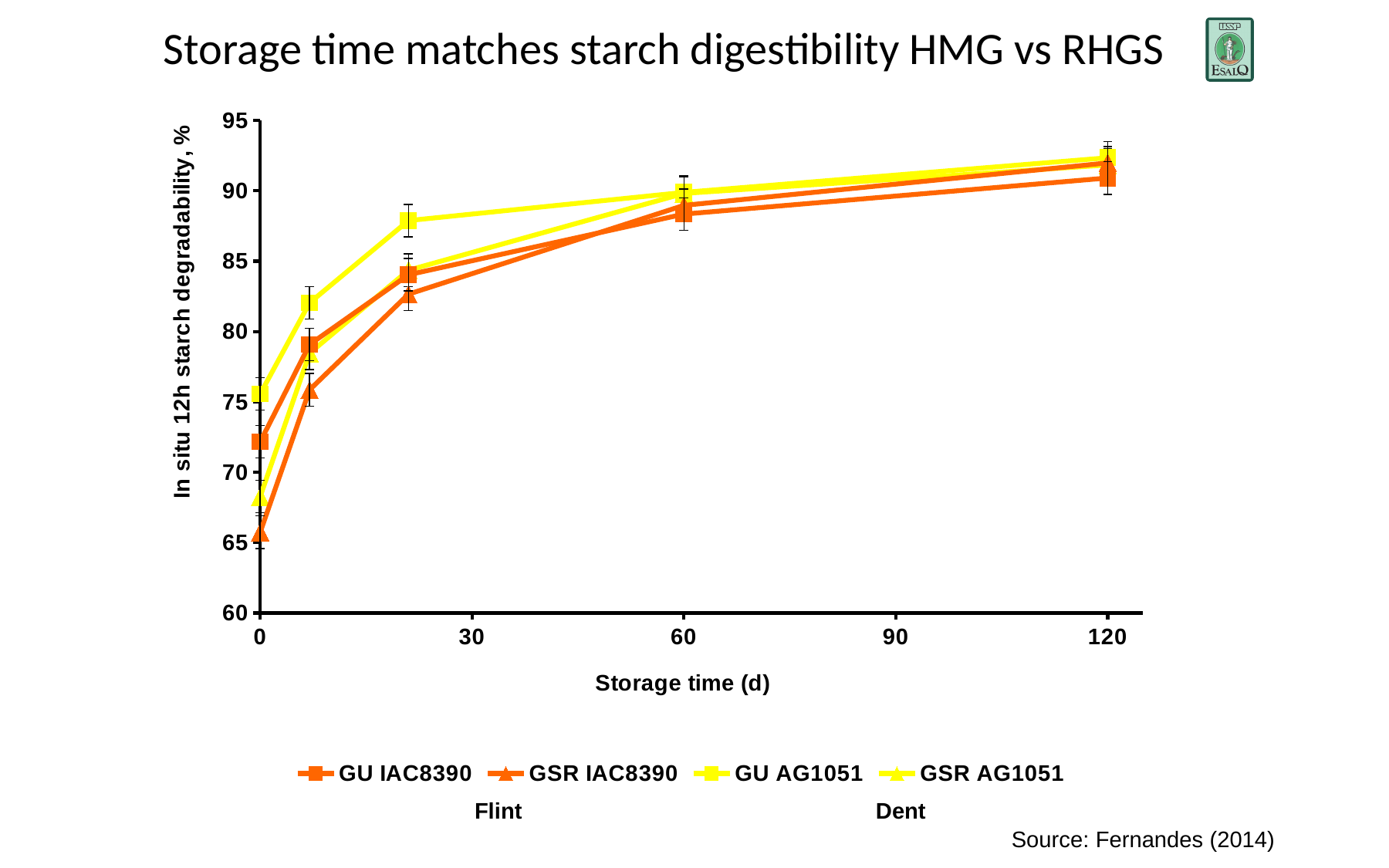
Is the value for GSR IAC8390 at storage time 0 d greater or less than 70? less What kind of chart is shown on the slide? line chart Is the value for GU IAC8390 at storage time 0 d greater or less than 75? less Which series has the highest value at storage time 0 d? GU AG1051 Which series has the lowest value at storage time 0 d? GSR IAC8390 What is the label of the y axis? In situ 12h starch degradability, % How many storage time points are plotted for each series? 5 How many series does the legend list? 4 What is the label of the x axis? Storage time (d) Do the values for GU IAC8390 rise or fall as storage time increases? rise Is the value for GU AG1051 at storage time 0 d greater or less than 70? greater At storage time 0 d, which is larger: GU AG1051 or GSR AG1051? GU AG1051